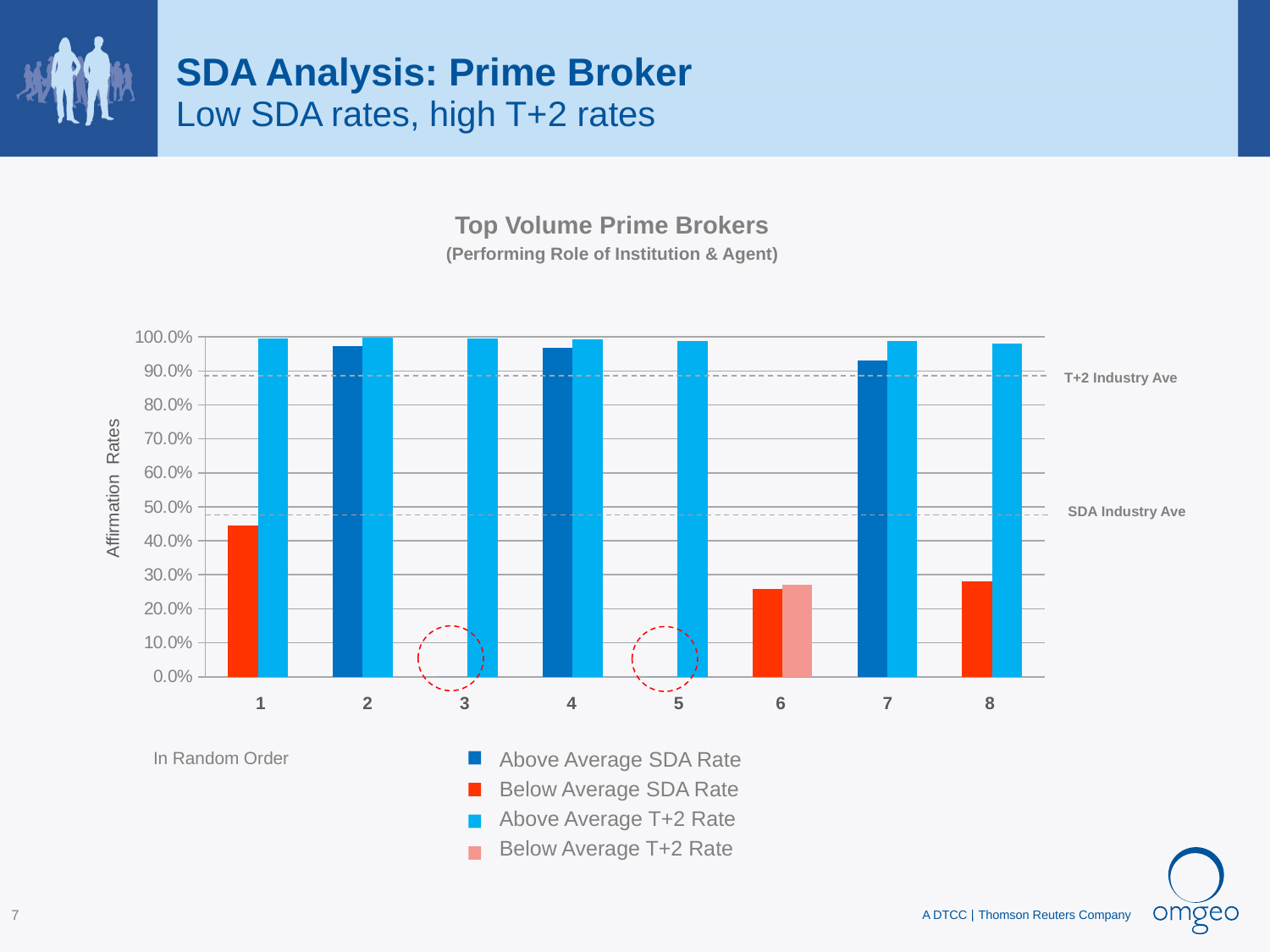
Which brokers have no SDA rate bar plotted (marked with dashed circles)? 3 and 5 Is the T+2 rate for broker 6 greater or less than 30%? less Which broker has the lowest T+2 rate? 6 Is the T+2 rate for broker 3 greater or less than 90%? greater Is the SDA rate for broker 7 greater or less than 90%? greater What is the title of the chart? Top Volume Prime Brokers How many prime brokers (categories) are shown on the x axis? 8 Which has the larger SDA rate, broker 1 or broker 7? broker 7 How many series does the legend list? 4 What kind of chart is shown on the slide? bar chart